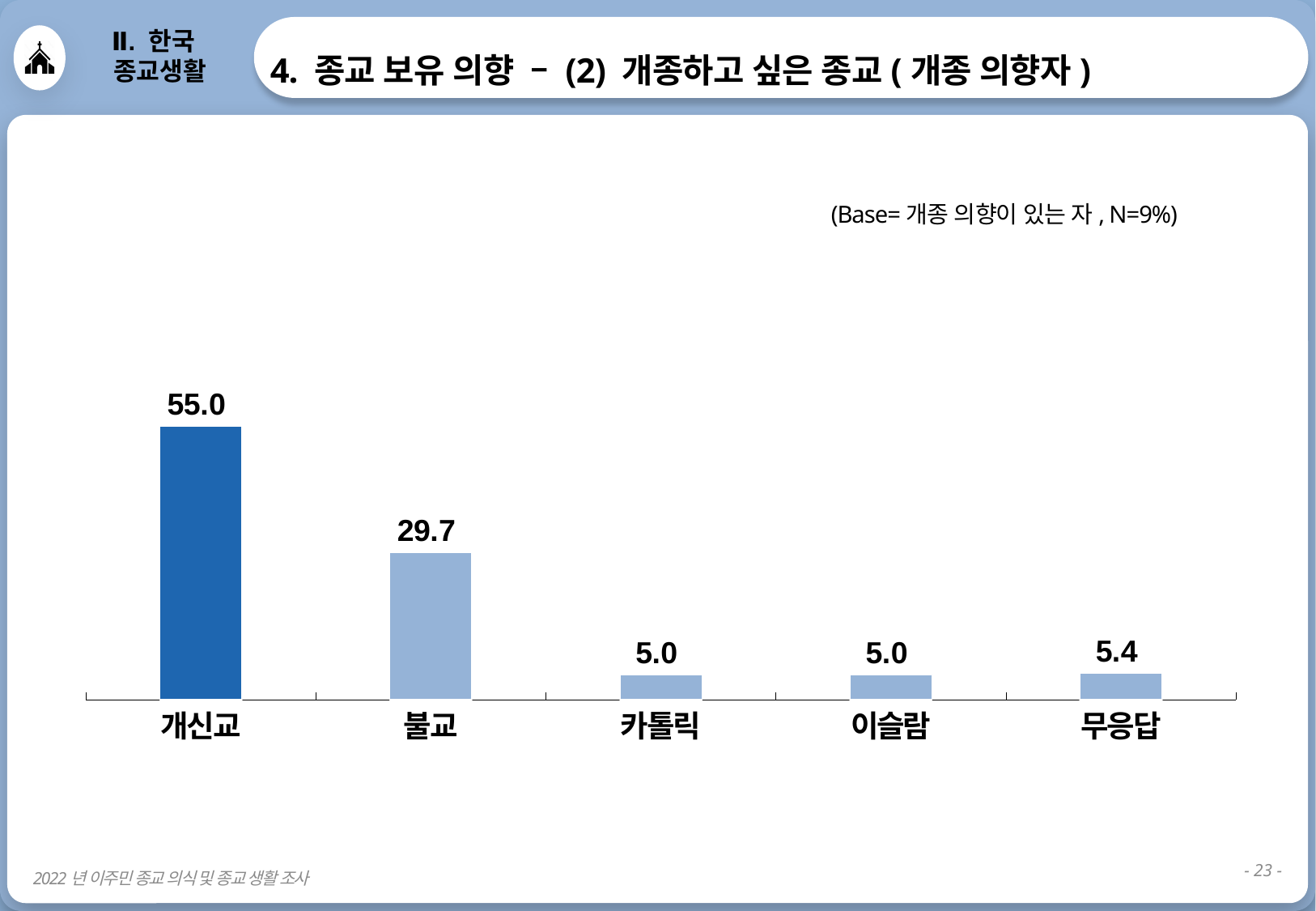
Which bar is drawn in a darker blue than the others? 개신교 What is the value for 개신교? 55.0 What is the difference between the values for 개신교 and 불교? 25.3 What is the value for 무응답? 5.4 What is the base note shown above the chart? (Base= 개종 의향이 있는 자 , N=9%) What is the value for 불교? 29.7 What is the difference between the values for 무응답 and 이슬람? 0.4 How many categories are shown on the x axis? 5 Which category has the highest value? 개신교 What is the value for 카톨릭? 5.0 What kind of chart is shown on the slide? bar chart Which is larger, the value for 불교 or the value for 무응답? 불교